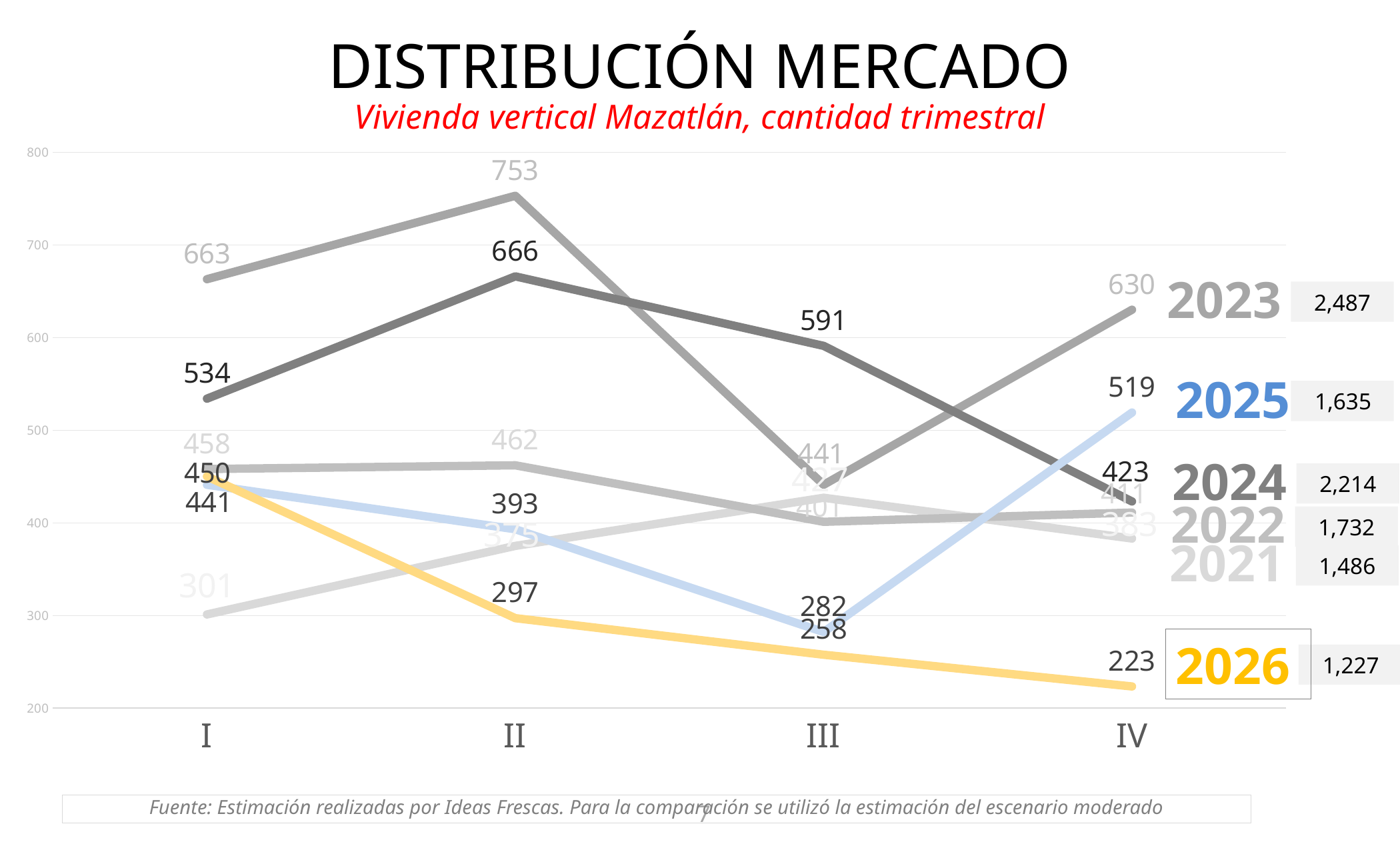
How many quarters are shown on the x axis? 4 What is the value for 2023 in quarter II? 753 What is the value for 2024 in quarter III? 591 What is the value for 2025 in quarter IV? 519 How many series (years) does the chart show? 6 What is the difference between the 2023 and 2024 values in quarter II? 87 Which year has the highest value in quarter II? 2023 Does the 2026 line rise or fall from quarter I to quarter IV? fall What kind of chart is shown on the slide? line chart What is the value for 2026 in quarter IV? 223 Which year has the lowest value in quarter IV? 2026 In quarter IV, which is larger: the value for 2025 or the value for 2024? 2025